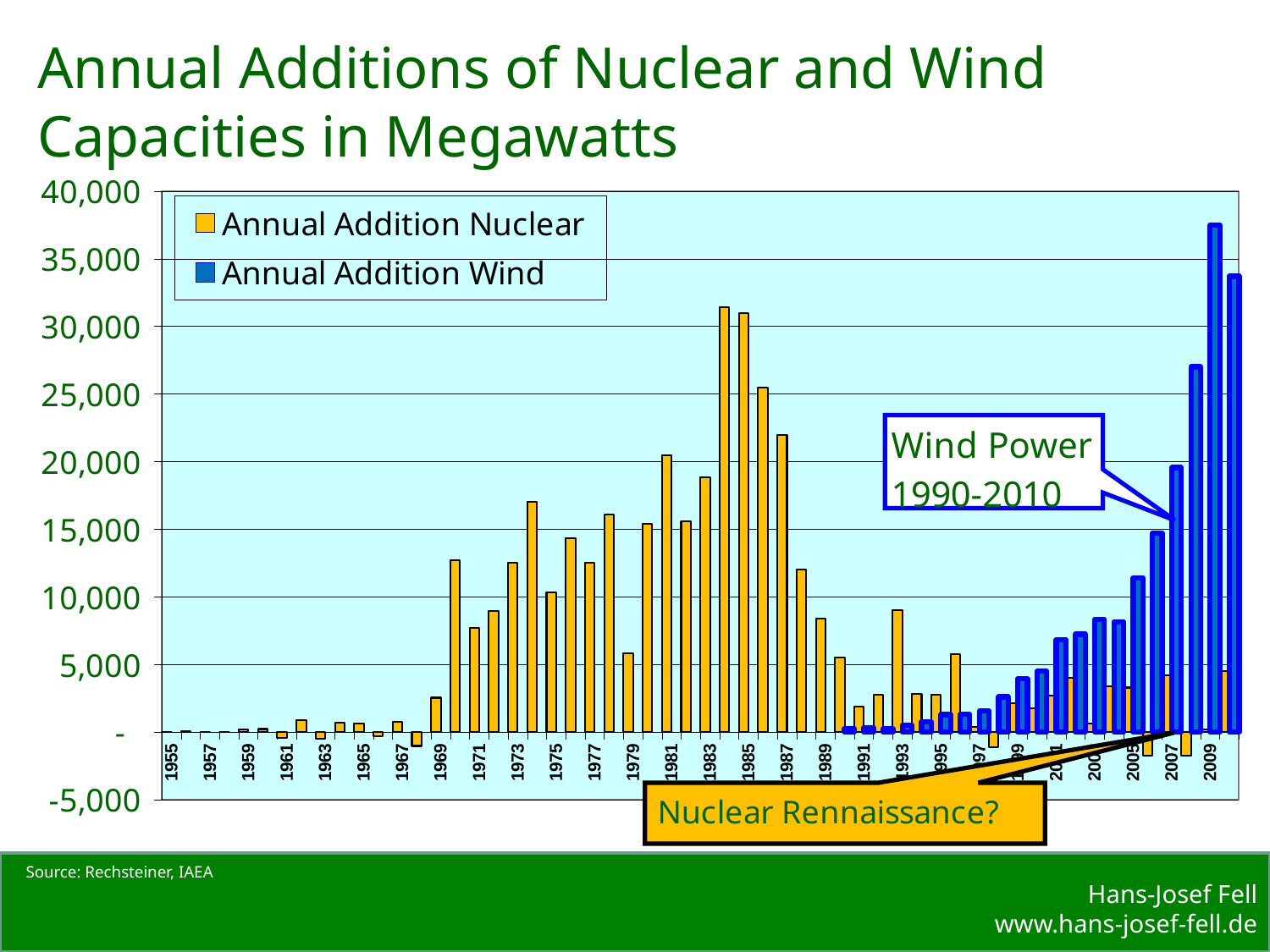
In which year is the Annual Addition Wind bar highest? 2009 Which is larger: the Annual Addition Wind bar for 2009 or the Annual Addition Nuclear bar for 1984? Annual Addition Wind for 2009 How many series does the legend list? 2 Which colour represents Annual Addition Wind? blue What type of chart is shown on the slide? bar chart Which is larger: the Annual Addition Nuclear value for 1986 or for 1987? 1986 Is the Annual Addition Wind value for 2008 greater or less than 25,000? greater Is the Annual Addition Nuclear value for 1984 greater or less than 30,000? greater Is the Annual Addition Wind value for 2009 greater or less than 35,000? greater What are the two series named in the legend? Annual Addition Nuclear; Annual Addition Wind Do the Annual Addition Wind values generally rise or fall from 2000 to 2009? rise